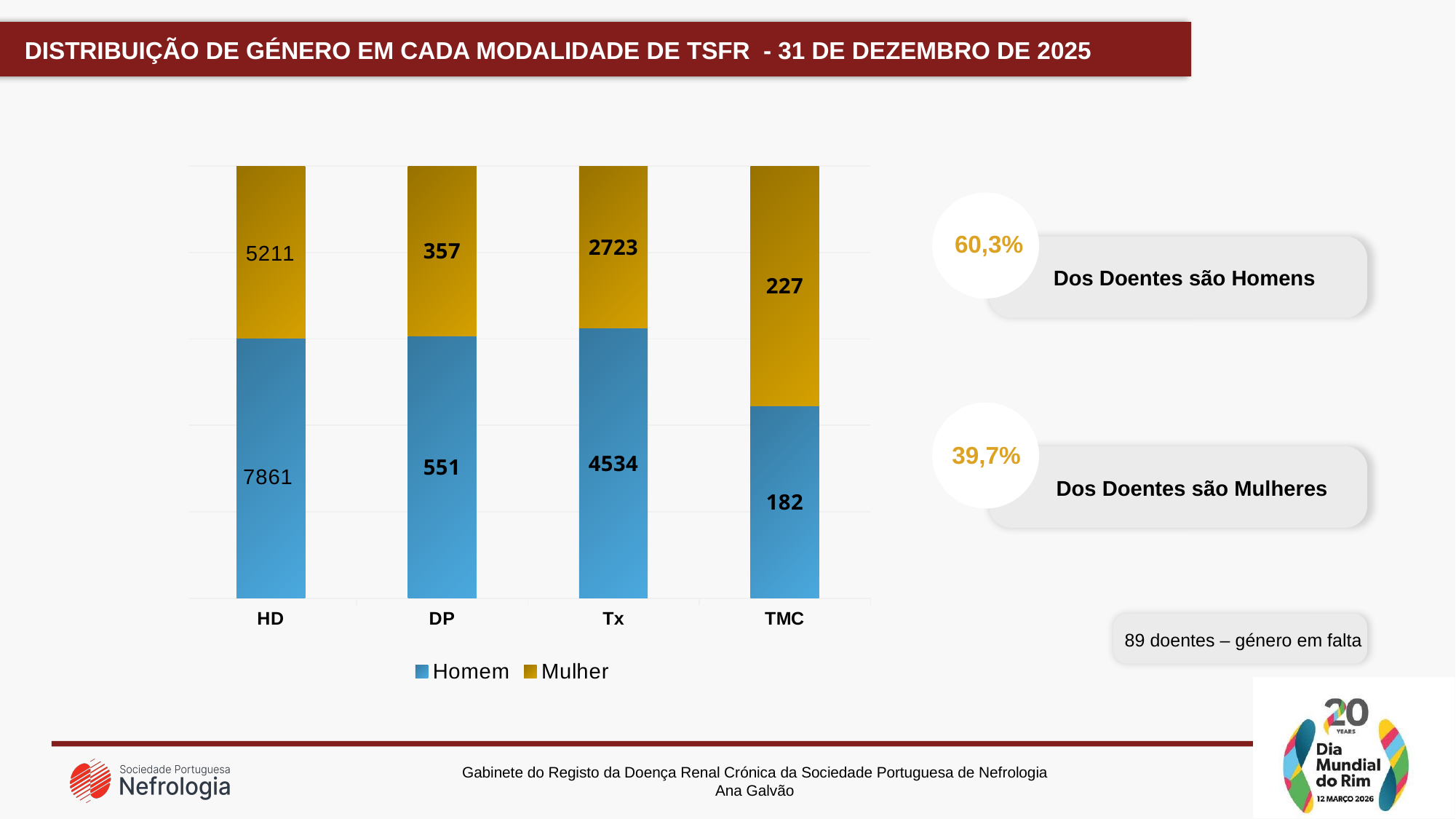
What is the total of the Homem and Mulher values in the Tx category? 7257 How many series does the legend list? 2 What kind of chart is shown on the slide? Stacked bar chart Which category has the lowest Mulher value? TMC Which category has the highest Homem value? HD What is the value for Mulher in the Tx category? 2723 What is the value for Homem in the HD category? 7861 What is the value for Mulher in the TMC category? 227 In the TMC category, which is larger, the Homem value or the Mulher value? Mulher What is the value for Homem in the DP category? 551 How many categories are shown on the x axis? 4 What is the difference between the Homem and Mulher values in the HD category? 2650